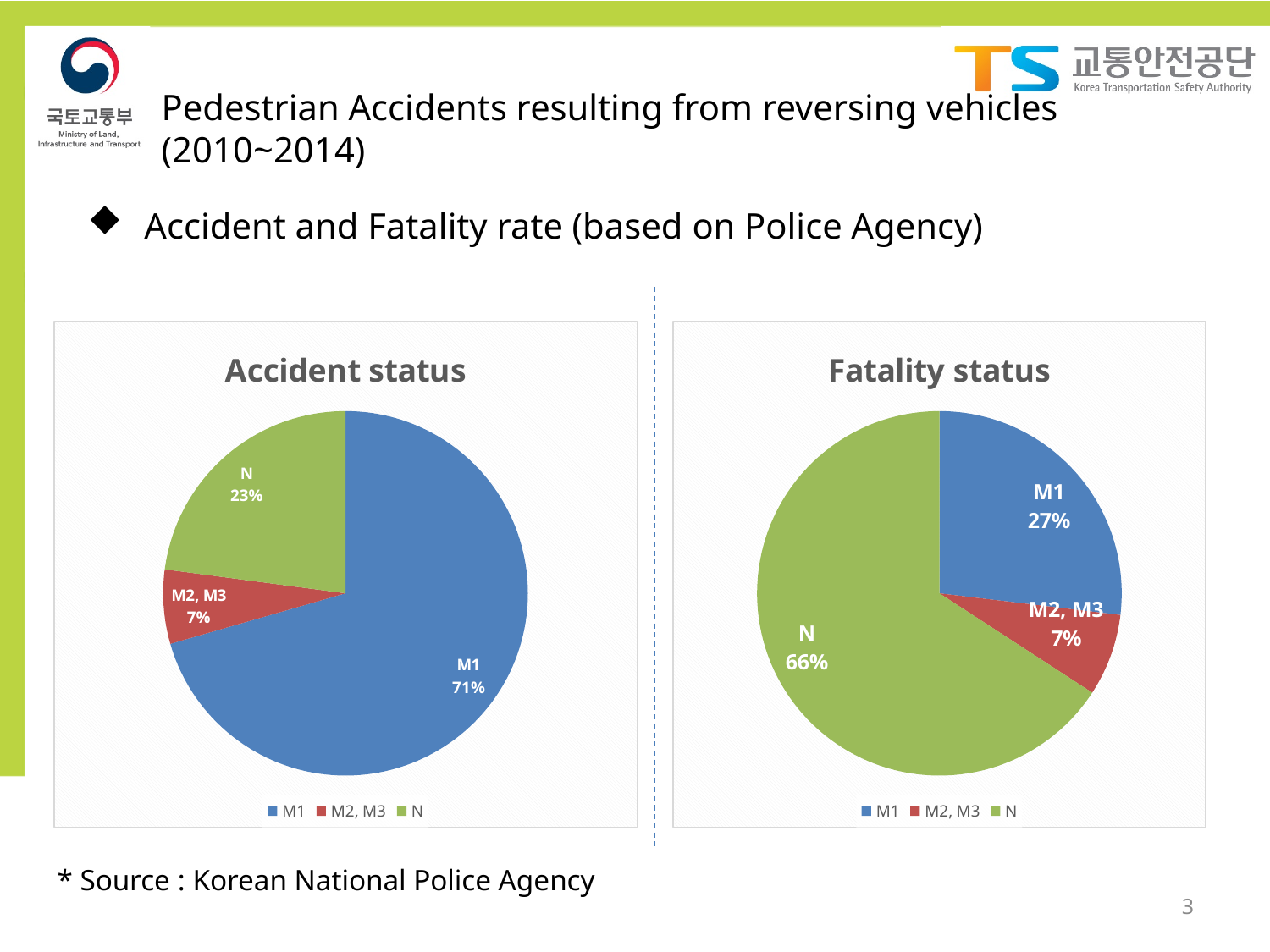
In the 'Accident status' chart, which category has the largest slice? M1 In the 'Accident status' chart, what share does M1 have? 71% How many categories does the legend of the 'Accident status' chart list? 3 In the 'Fatality status' chart, which is larger, the M1 share or the M2, M3 share? M1 What kind of chart is the 'Fatality status' chart? Pie chart In the 'Accident status' chart, what is the difference between the M1 share and the N share? 48% In the 'Fatality status' chart, what share does M1 have? 27% In the 'Accident status' chart, what share does N have? 23% In the 'Fatality status' chart, which category has the largest slice? N In the 'Fatality status' chart, what is the difference between the N share and the M1 share? 39% In the 'Accident status' chart, which category has the smallest slice? M2, M3